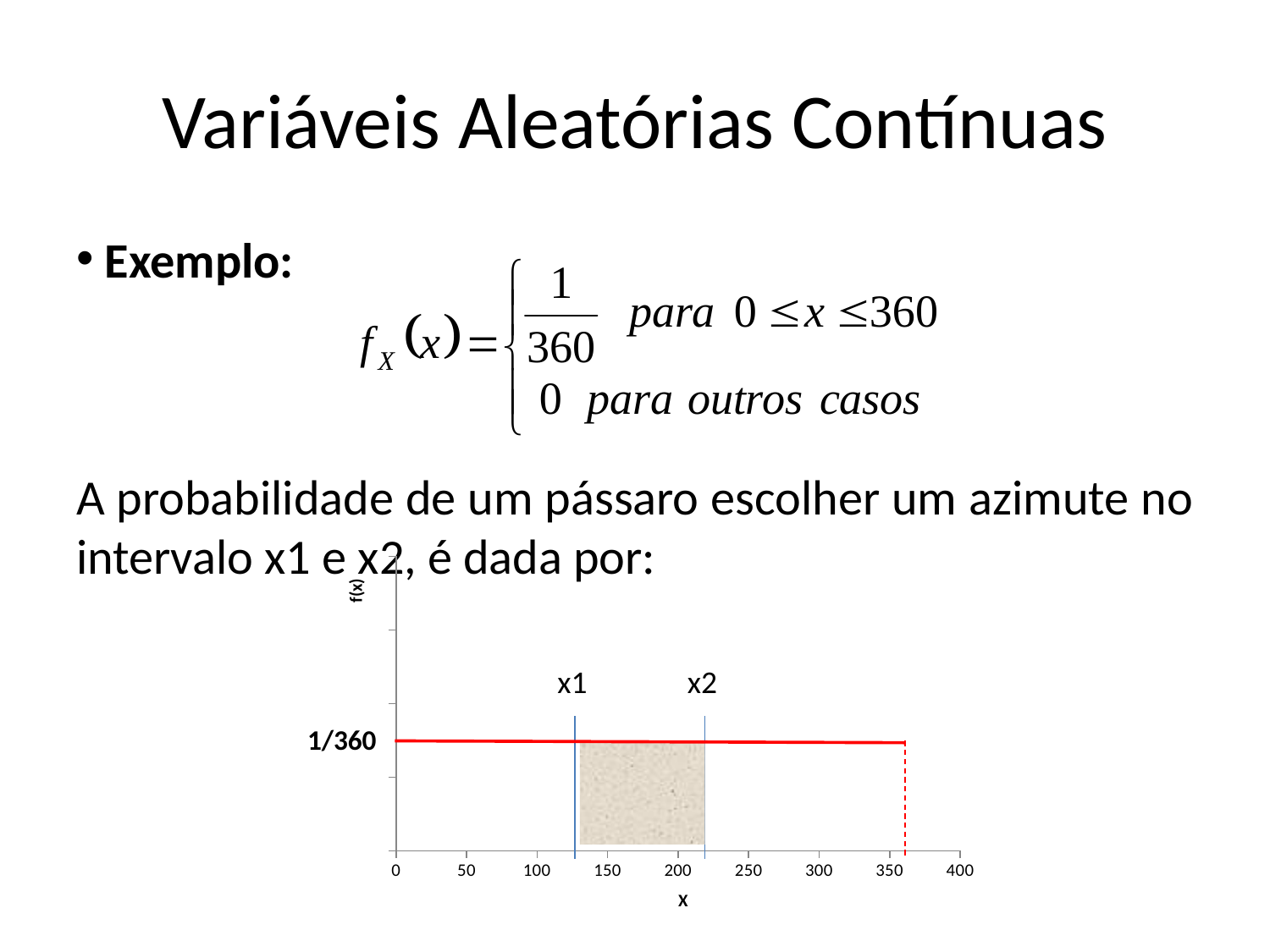
What is the label on the vertical axis of the chart? f(x) Is the position of x2 on the x axis greater or less than 250? less Is the position of x1 on the x axis greater or less than 100? greater Is the position of x2 on the x axis greater or less than 200? greater What kind of chart is shown at the bottom of the slide? line chart What is the label on the horizontal axis of the chart? x Does the red line rise, fall, or stay flat as x increases from 0 to 360? stays flat What value of f(x) is labelled on the vertical axis where the red line sits? 1/360 Which of the two marked points, x1 or x2, lies further to the right on the x axis? x2 What is the largest tick value shown on the x axis? 400 How many tick labels are shown on the x axis? 9